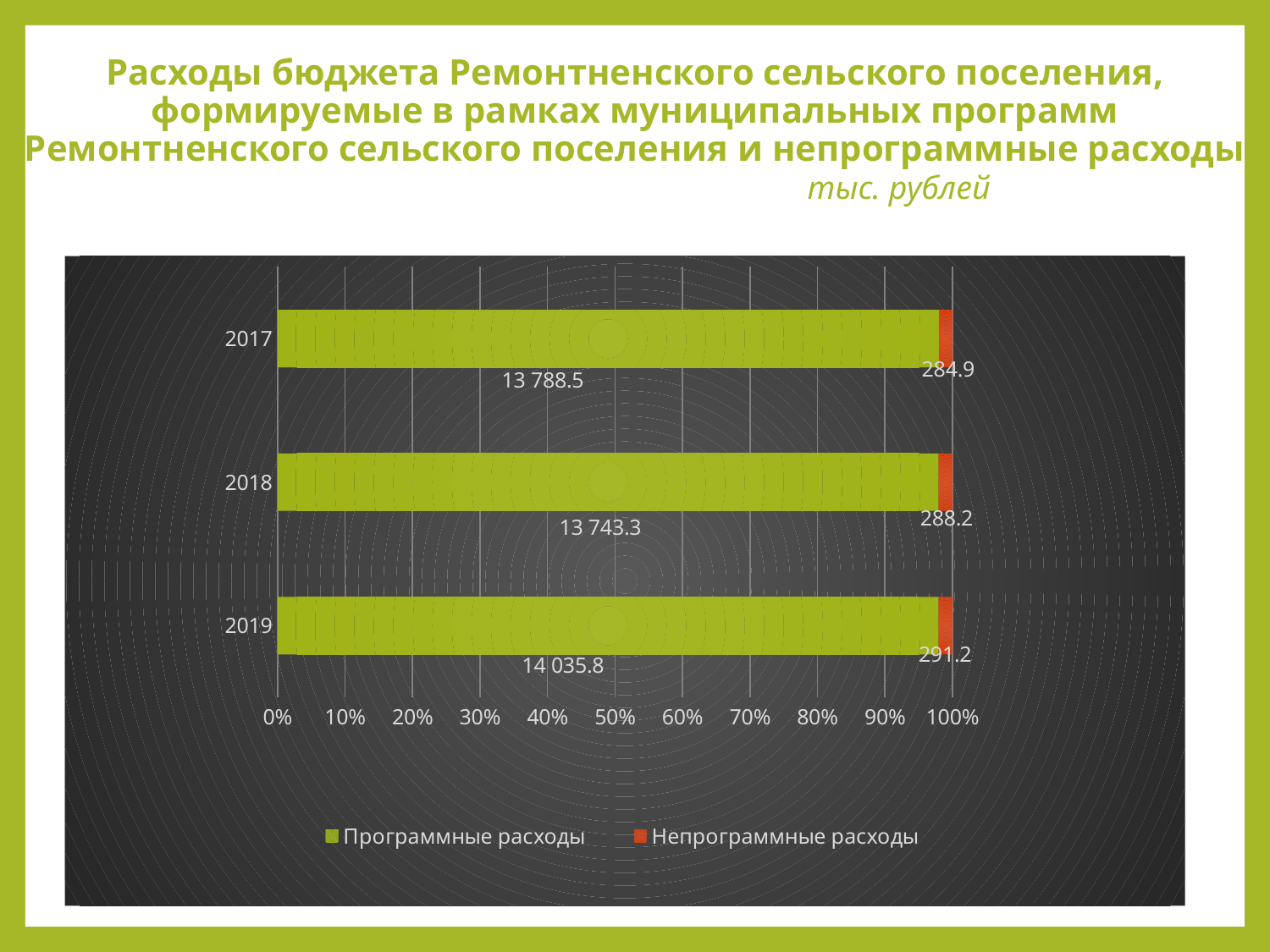
How many years are shown on the chart? 3 How many series does the legend list? 2 What is the value of Непрограммные расходы for 2019? 291.2 In which year is Непрограммные расходы lowest? 2017 What is the total of Программные расходы and Непрограммные расходы for 2019? 14 327.0 What is the difference between Программные расходы in 2019 and in 2017? 247.3 In which year is Программные расходы lowest? 2018 What is the value of Программные расходы for 2017? 13 788.5 Which is larger: Непрограммные расходы in 2018 or in 2017? 2018 In which year is Программные расходы highest? 2019 What is the value of Непрограммные расходы for 2018? 288.2 What kind of chart is shown on the slide? Bar chart